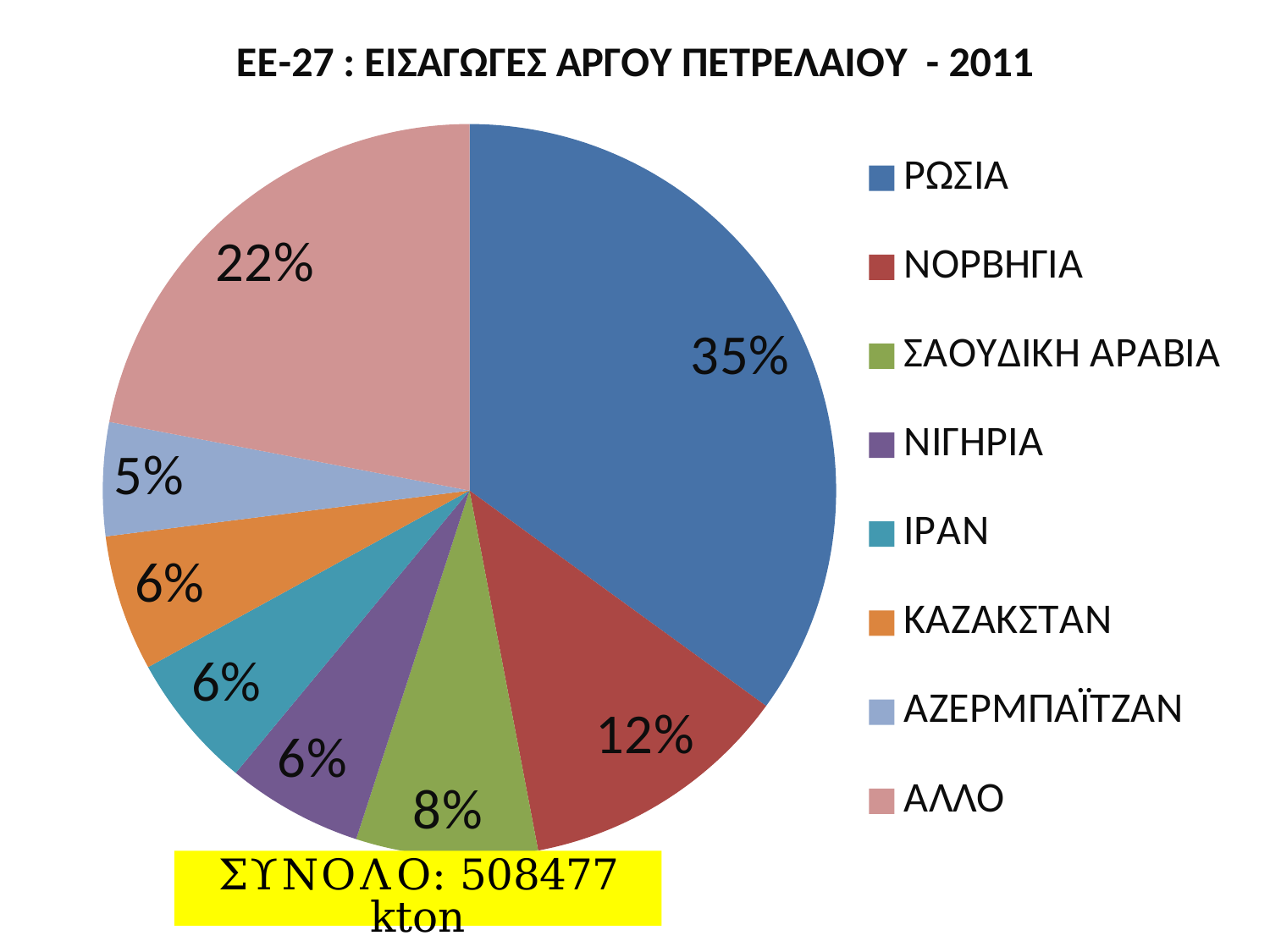
What percentage is shown for ΑΛΛΟ? 22% What share of the pie does ΡΩΣΙΑ account for? 35% What is the difference in percentage points between ΡΩΣΙΑ and ΝΟΡΒΗΓΙΑ? 23 Which is larger, the share for ΑΛΛΟ or the share for ΝΟΡΒΗΓΙΑ? ΑΛΛΟ What total is shown in the yellow box below the chart? 508477 kton What type of chart is shown on the slide? pie chart Which category has the smallest slice of the pie? ΑΖΕΡΜΠΑΪΤΖΑΝ What percentage is shown for ΝΟΡΒΗΓΙΑ? 12% What percentage is shown for ΑΖΕΡΜΠΑΪΤΖΑΝ? 5% What percentage is shown for ΣΑΟΥΔΙΚΗ ΑΡΑΒΙΑ? 8% How many categories does the legend list? 8 Which category has the largest slice of the pie? ΡΩΣΙΑ